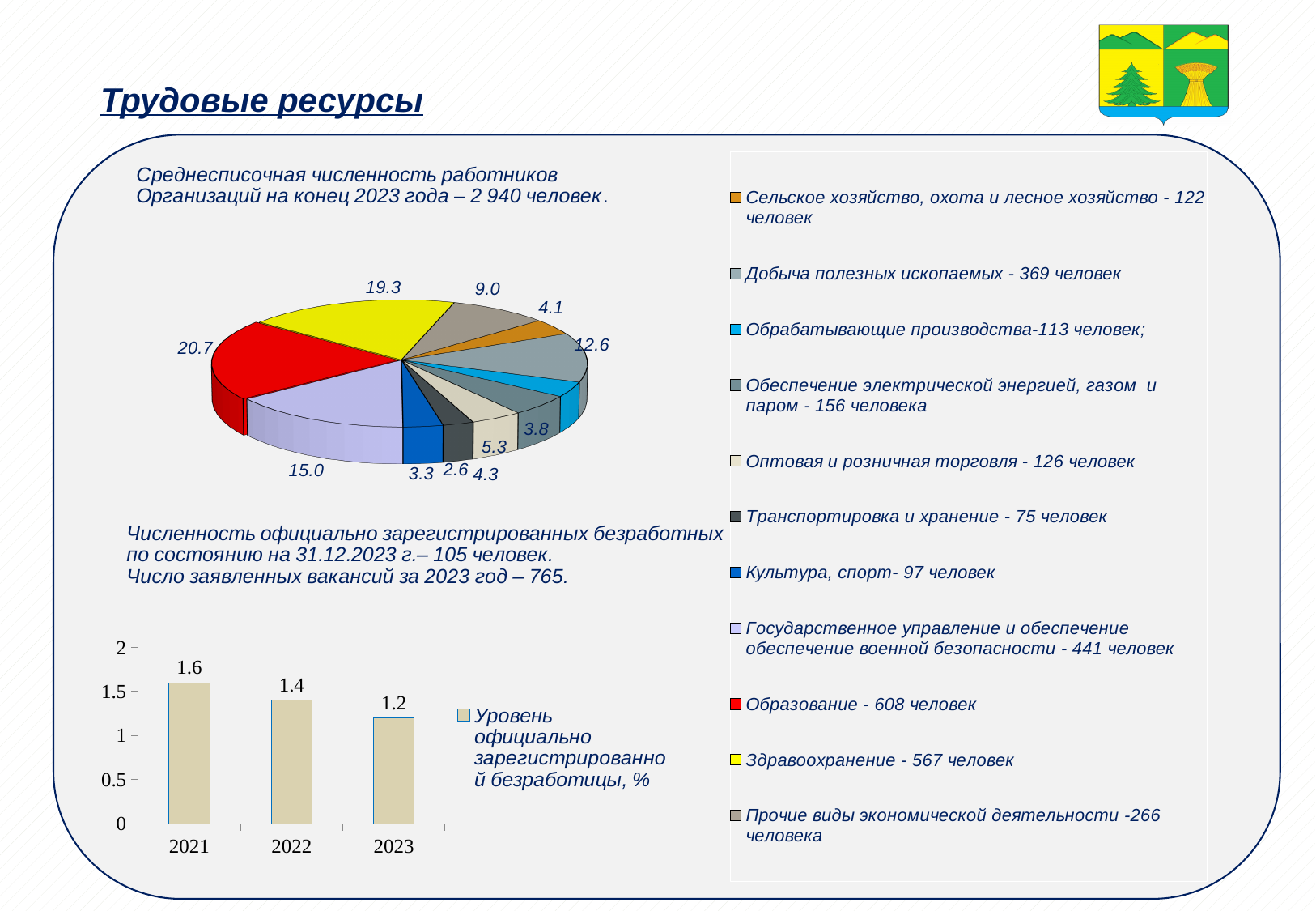
How many series does the legend of the bar chart at the bottom left list? 1 In the pie chart at the top left, what is the value shown for the yellow slice (Здравоохранение)? 19.3 According to the legend of the pie chart, how many people work in Образование? 608 человек In the bar chart at the bottom left, do the values rise or fall from 2021 to 2023? fall In the pie chart at the top left, which slice is the largest? Образование (20.7) In the bar chart at the bottom left, what is the value for 2021? 1.6 In the bar chart at the bottom left, what is the value for 2023? 1.2 In the bar chart at the bottom left, which year has the lowest value? 2023 What kind of chart is the chart at the bottom left of the slide? bar chart How many slices does the pie chart at the top left have? 11 In the bar chart at the bottom left, what is the difference between the values for 2021 and 2023? 0.4 In the pie chart at the top left, which slice is the smallest? Транспортировка и хранение (2.6)